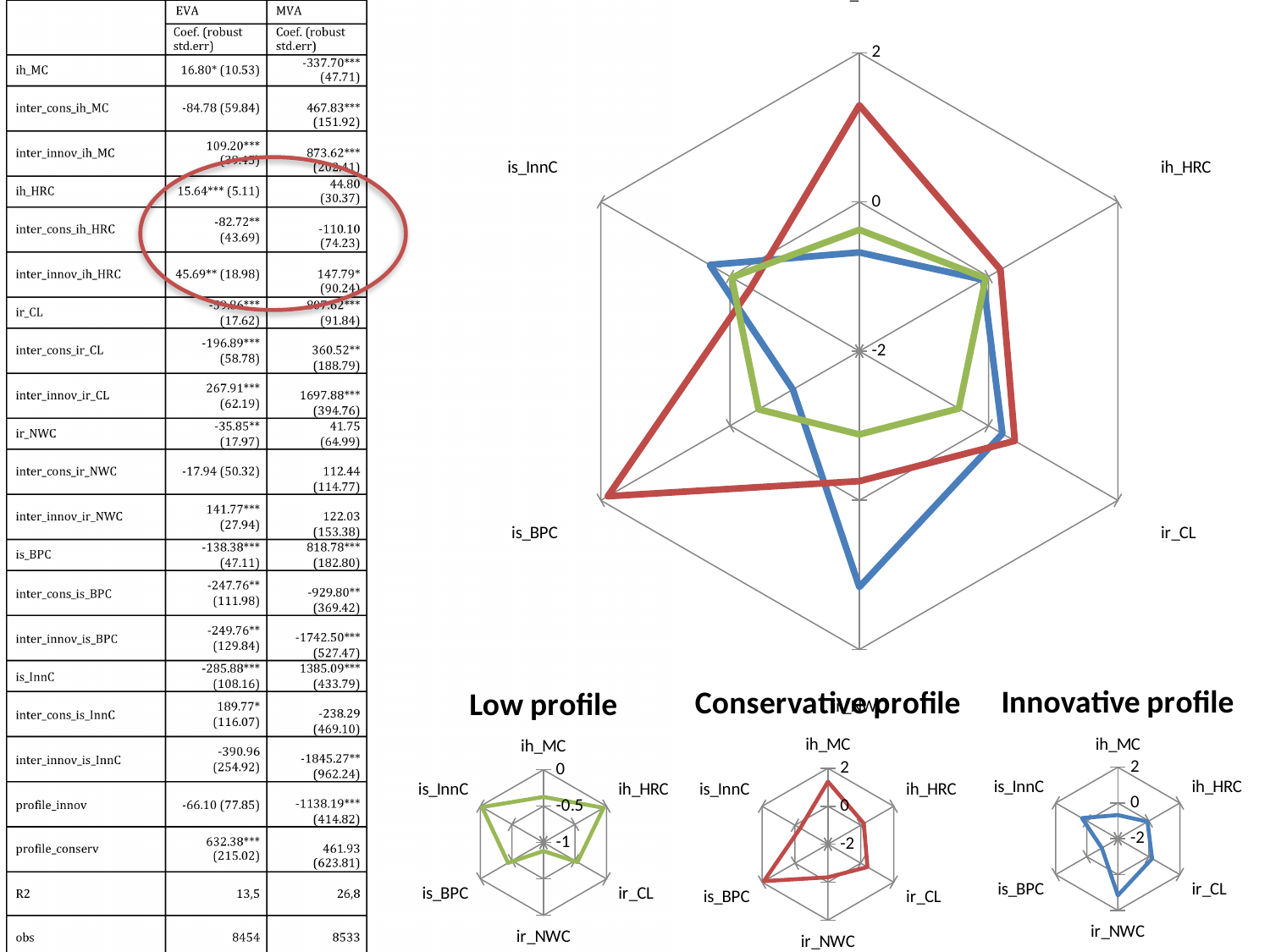
On the large radar chart, is the value of the red series for ih_MC greater or less than 0? greater On the large radar chart, is the value of the blue series for ir_NWC greater or less than 0? greater On the large radar chart, which series has the larger value for ir_NWC, the blue series or the green series? Blue What colour is the line on the Low profile radar chart? Green On the Conservative profile chart, is the value for is_BPC greater or less than 0? greater How many data series are plotted on the large radar chart? 3 What are the titles of the three small radar charts at the bottom of the slide? Low profile, Conservative profile, Innovative profile How many axes (categories) does the large radar chart have? 6 What kind of chart is the large chart on the right side of the slide? Radar chart On the large radar chart, which series has the larger value for is_BPC, the red series or the green series? Red